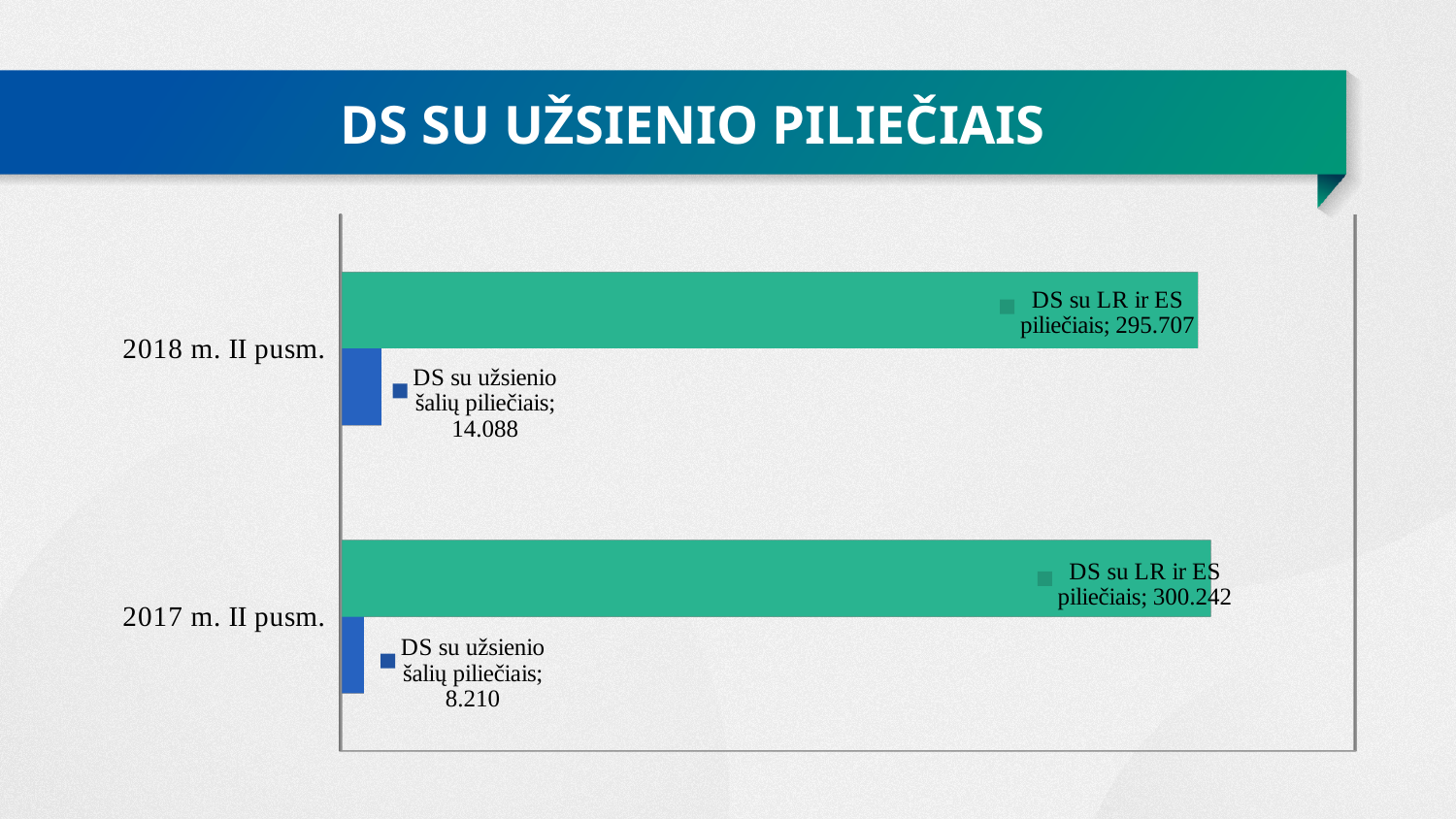
What is the value for DS su užsienio šalių piliečiais in 2018 m. II pusm.? 14.088 How many data series are shown on the chart? 2 What is the difference between the DS su LR ir ES piliečiais values for 2017 m. II pusm. and 2018 m. II pusm.? 4.535 What is the value for DS su užsienio šalių piliečiais in 2017 m. II pusm.? 8.210 What is the difference between the DS su užsienio šalių piliečiais values for 2018 m. II pusm. and 2017 m. II pusm.? 5.878 Which period has the higher value for DS su LR ir ES piliečiais? 2017 m. II pusm. Is the value for DS su užsienio šalių piliečiais larger in 2018 m. II pusm. or in 2017 m. II pusm.? 2018 m. II pusm. What kind of chart is shown on the slide? Bar chart How many periods (categories) are shown on the chart? 2 What is the value for DS su LR ir ES piliečiais in 2018 m. II pusm.? 295.707 What is the value for DS su LR ir ES piliečiais in 2017 m. II pusm.? 300.242 Which period has the lower value for DS su užsienio šalių piliečiais? 2017 m. II pusm.